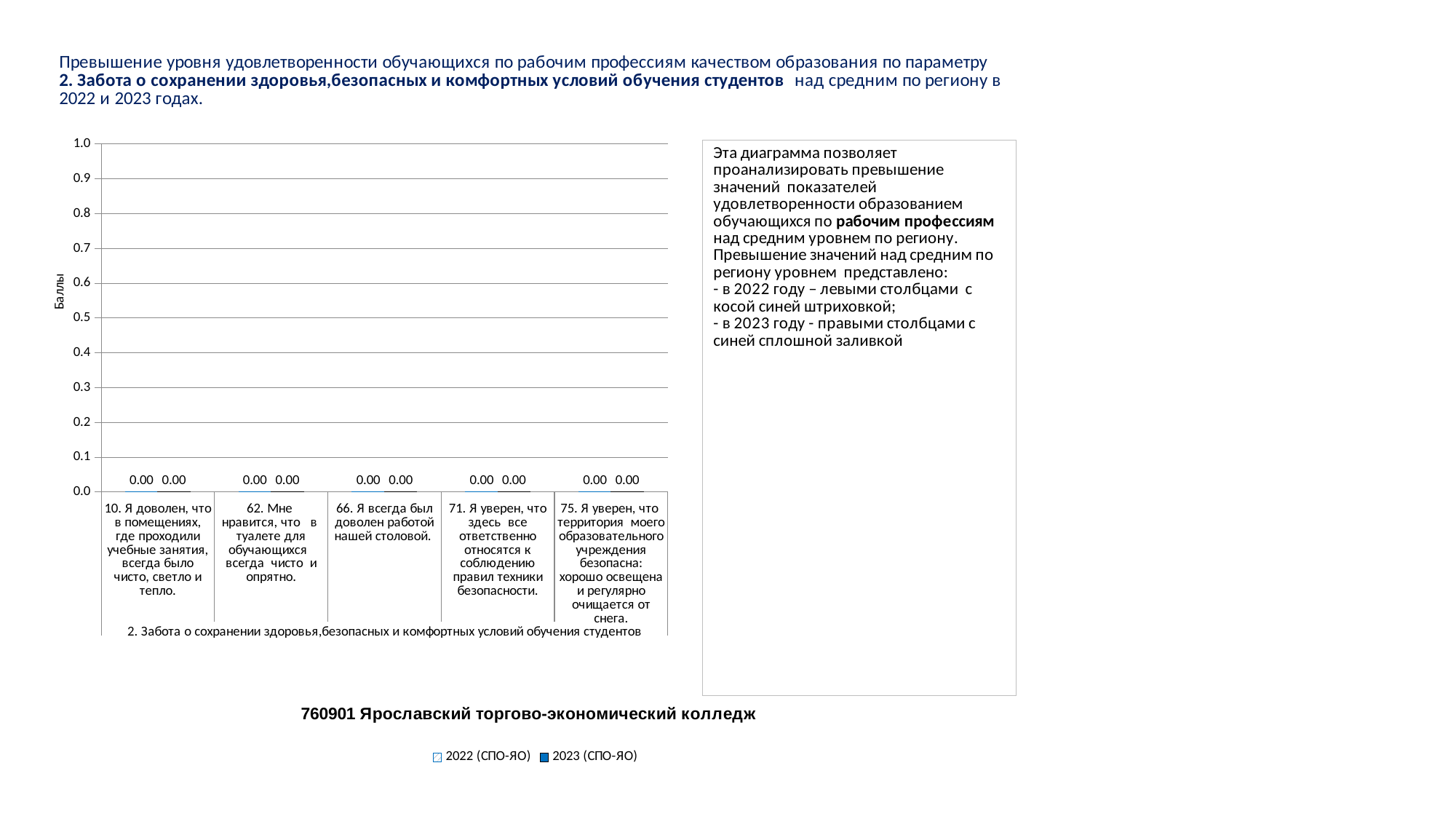
Is the value of the 2022 (СПО-ЯО) series for category "66. Я всегда был доволен работой нашей столовой." greater or less than 0.1? less What is the highest value shown on the y axis of the chart? 1.0 What is the value of the 2023 (СПО-ЯО) series for category "66. Я всегда был доволен работой нашей столовой."? 0.00 How many series does the chart legend list? 2 What is the value of the 2022 (СПО-ЯО) series for category "75. Я уверен, что территория моего образовательного учреждения безопасна: хорошо освещена и регулярно очищается от снега."? 0.00 What is the label of the y axis of the chart? Баллы What is the title of the chart? 760901 Ярославский торгово-экономический колледж What is the value of the 2023 (СПО-ЯО) series for category "62. Мне нравится, что в туалете для обучающихся всегда чисто и опрятно."? 0.00 What is the difference between the 2023 (СПО-ЯО) and 2022 (СПО-ЯО) values for category "71. Я уверен, что здесь все ответственно относятся к соблюдению правил техники безопасности."? 0.00 How many categories (questions) are shown on the x axis of the chart? 5 What is the value of the 2022 (СПО-ЯО) series for category "10. Я доволен, что в помещениях, где проходили учебные занятия, всегда было чисто, светло и тепло."? 0.00 What kind of chart is shown on the slide? bar chart